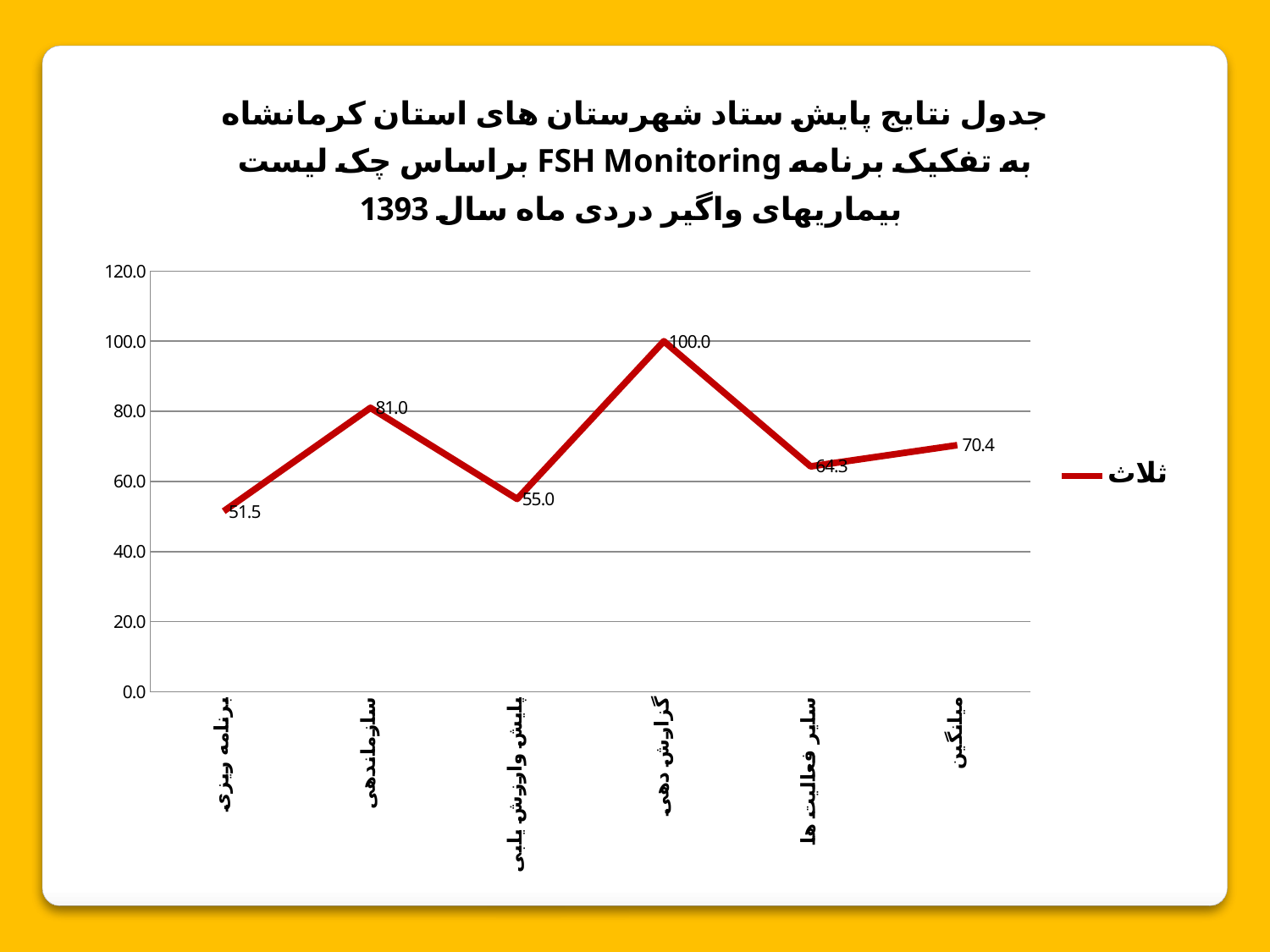
Which is larger, the value for سازماندهی or the value for سایر فعالیت ها? سازماندهی What is the value for میانگین? 70.4 What series name does the legend show? ثلاث What is the value for سازماندهی? 81.0 What is the value for سایر فعالیت ها? 64.3 Which category has the lowest value? برنامه ریزی Which category has the highest value? گزارش دهی What is the difference between the values for گزارش دهی and سازماندهی? 19.0 What is the value for برنامه ریزی? 51.5 How many categories are plotted on the x axis? 6 What is the value for گزارش دهی? 100.0 What type of chart is shown on the slide? line chart